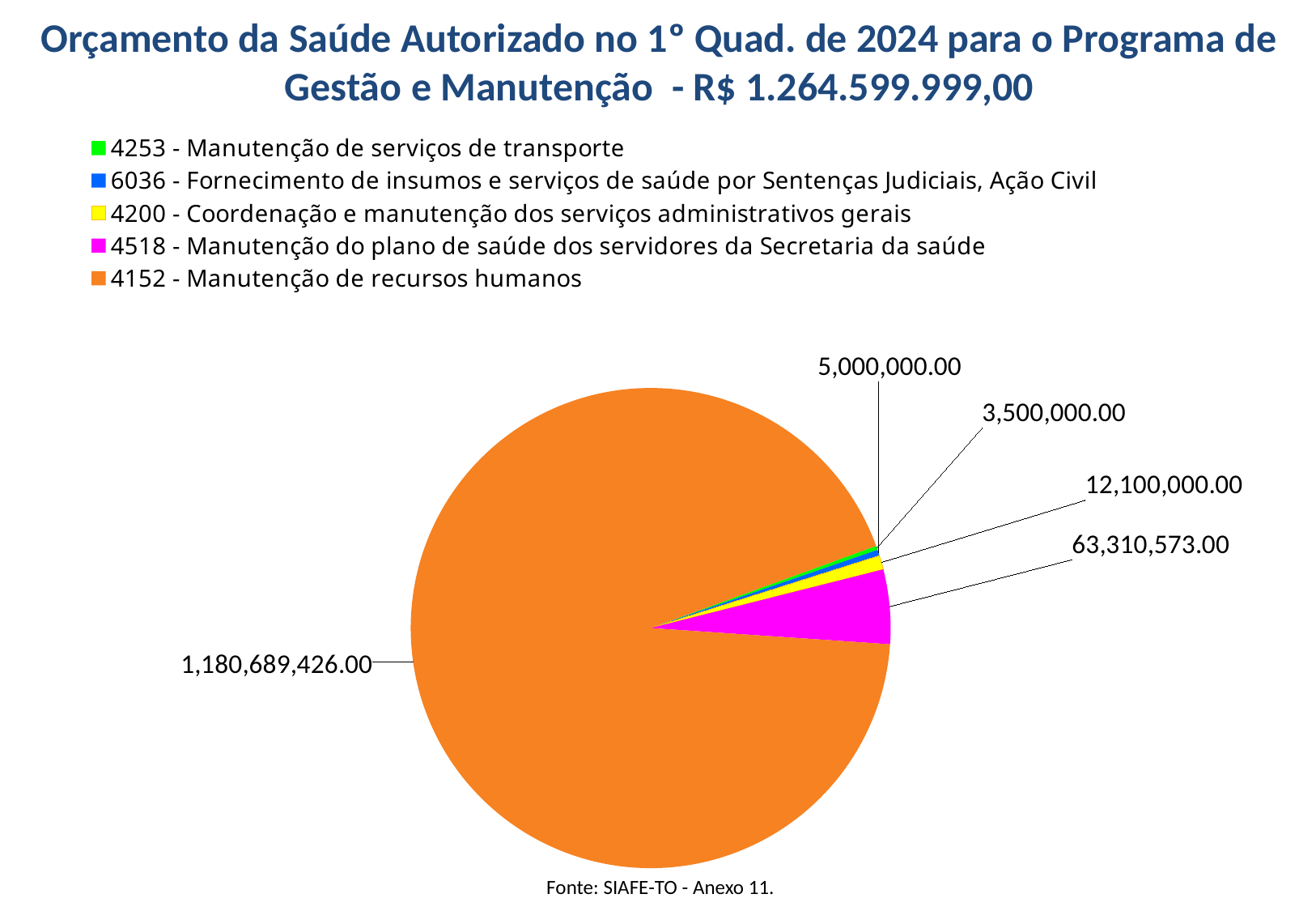
Which category has the largest slice of the pie? 4152 - Manutenção de recursos humanos How many entries does the legend list? 5 What is the value for 4253 - Manutenção de serviços de transporte? 3,500,000.00 What is the difference between the values for 4518 - Manutenção do plano de saúde dos servidores da Secretaria da saúde and 4200 - Coordenação e manutenção dos serviços administrativos gerais? 51,210,573.00 What is the value for 4518 - Manutenção do plano de saúde dos servidores da Secretaria da saúde? 63,310,573.00 What is the value for 4152 - Manutenção de recursos humanos? 1,180,689,426.00 Which colour represents 4518 - Manutenção do plano de saúde dos servidores da Secretaria da saúde in the pie chart? Magenta What type of chart is shown on the slide? Pie chart What is the value for 4200 - Coordenação e manutenção dos serviços administrativos gerais? 12,100,000.00 How many slices does the pie chart have? 5 Which category has the smallest value? 4253 - Manutenção de serviços de transporte What is the value for 6036 - Fornecimento de insumos e serviços de saúde por Sentenças Judiciais, Ação Civil? 5,000,000.00